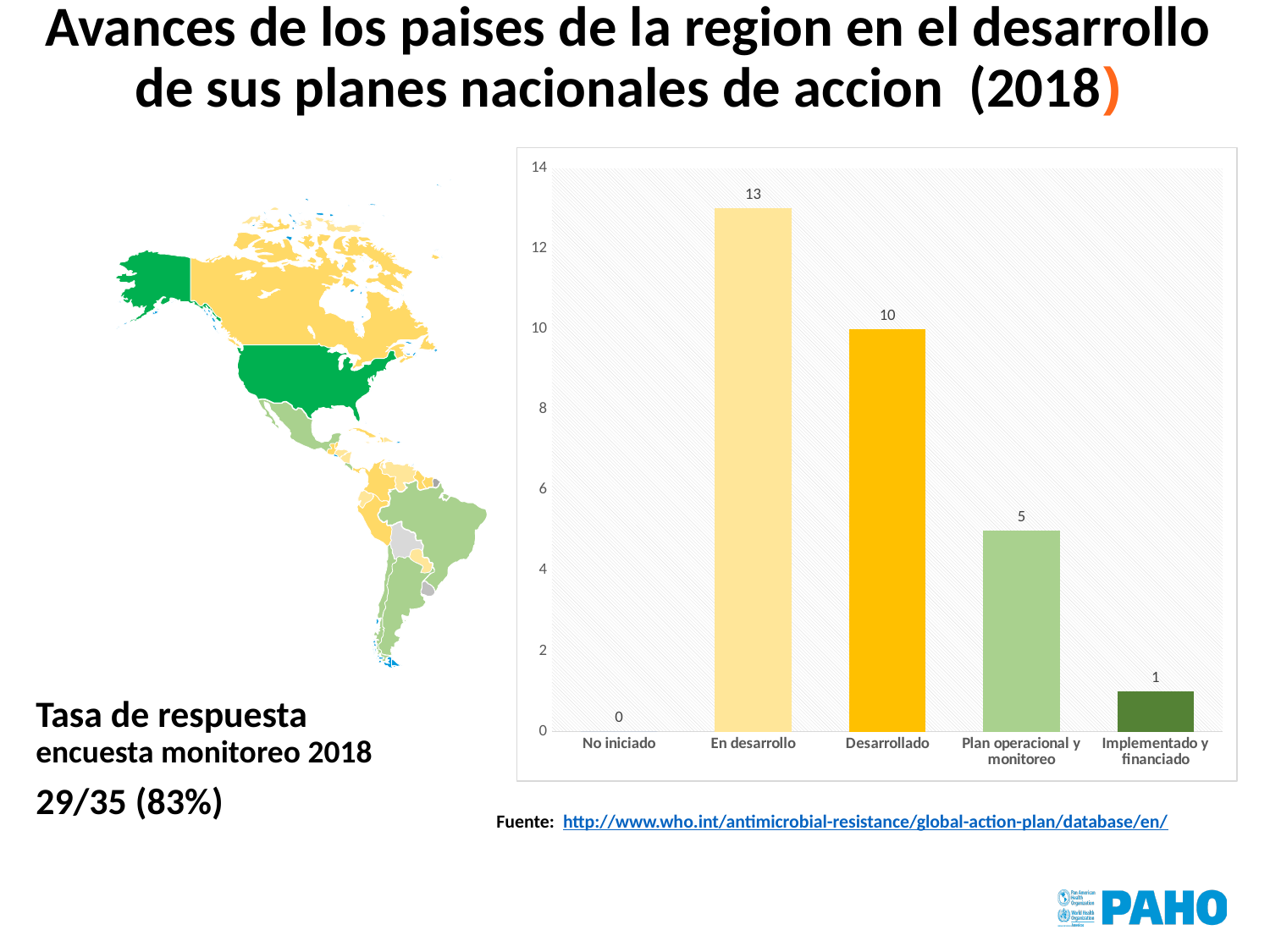
What is the difference between the values for En desarrollo and Desarrollado? 3 Which category has the highest value? En desarrollo What is the value for Implementado y financiado? 1 Which category has the lowest value? No iniciado What is the value for Plan operacional y monitoreo? 5 Which is larger, the value for Plan operacional y monitoreo or the value for Implementado y financiado? Plan operacional y monitoreo How many categories are shown on the x axis of the chart? 5 What is the value for En desarrollo? 13 What kind of chart is shown on the slide? Bar chart Do the values rise or fall from En desarrollo to Implementado y financiado along the x axis? Fall What is the value for Desarrollado? 10 What is the value for No iniciado? 0